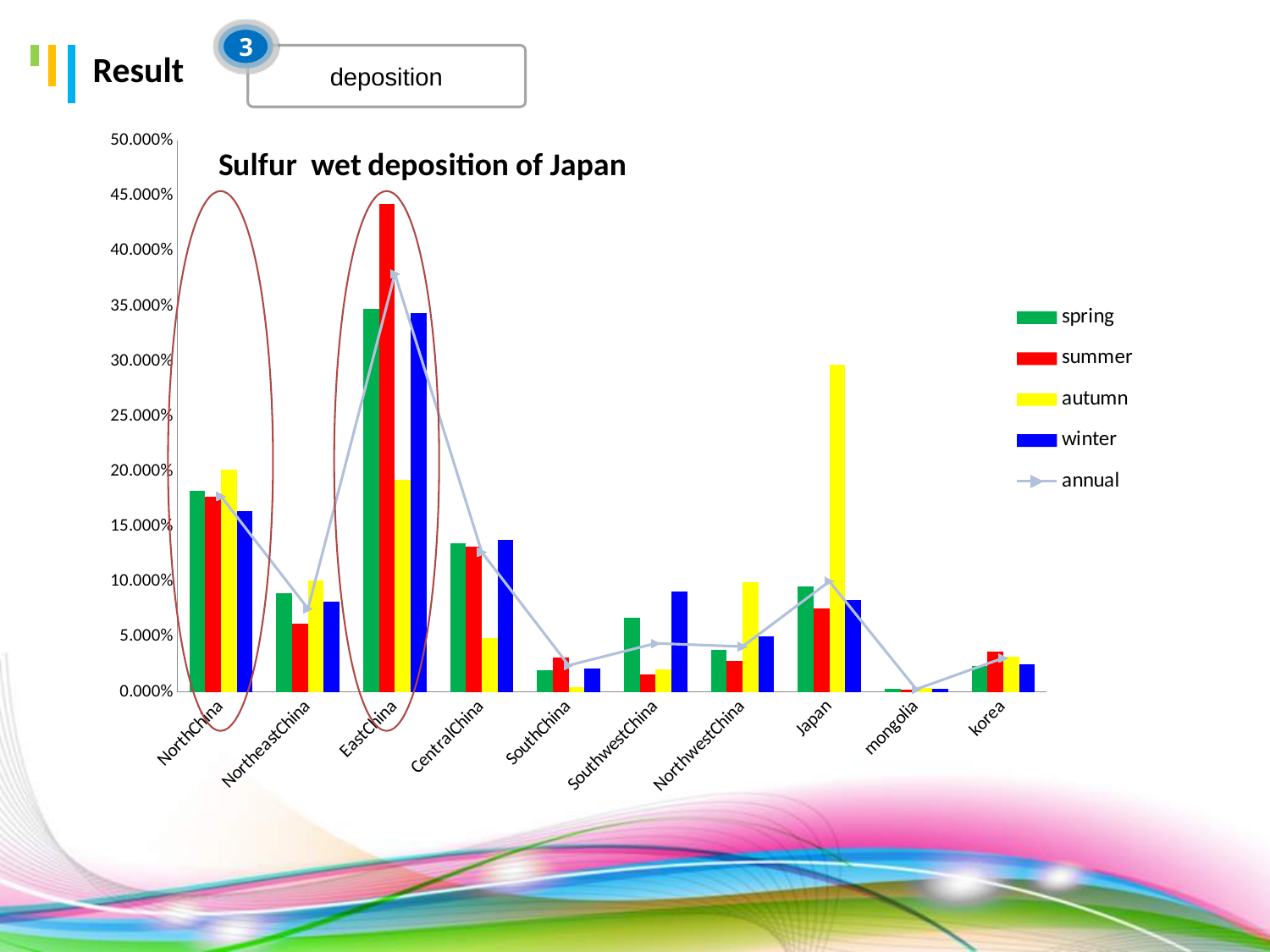
Is the winter value for SouthwestChina greater or less than 10.000%? less Which category has the highest summer bar? EastChina Which category has the highest autumn bar? Japan For NorthChina, which is larger, the autumn value or the winter value? autumn Which series is shown as a line with markers rather than bars? annual How many series does the legend list? 5 Is the autumn value for Japan greater or less than 25.000%? greater What is the title of the chart? Sulfur wet deposition of Japan Is the summer value for EastChina greater or less than 40.000%? greater How many categories are shown on the x axis? 10 What kind of chart is this? bar chart with a line Which category has the lowest annual value? mongolia